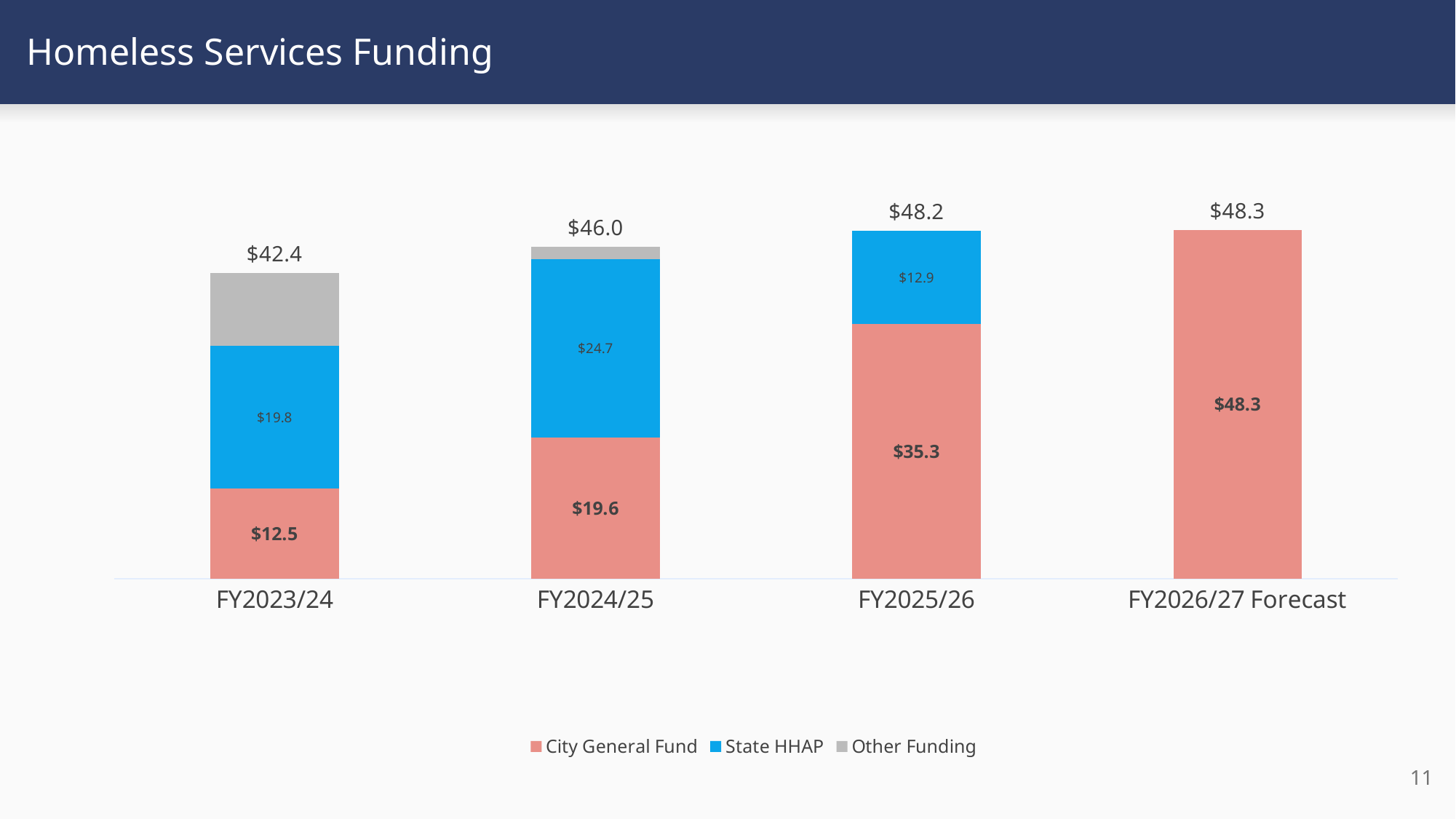
Which fiscal year has the highest total funding? FY2026/27 Forecast What is the total funding shown for FY2025/26? $48.2 What is the City General Fund value for FY2023/24? $12.5 How many series does the legend list? 3 What kind of chart is shown on the slide? Stacked bar chart Which is larger, the State HHAP value for FY2023/24 or for FY2025/26? FY2023/24 How much larger is the City General Fund value in FY2025/26 than in FY2024/25? $15.7 Which fiscal year has the lowest total funding? FY2023/24 What is the State HHAP value for FY2024/25? $24.7 How many fiscal years are shown on the x axis? 4 What is the City General Fund value for FY2026/27 Forecast? $48.3 What is the difference between the total funding for FY2024/25 and FY2023/24? $3.6